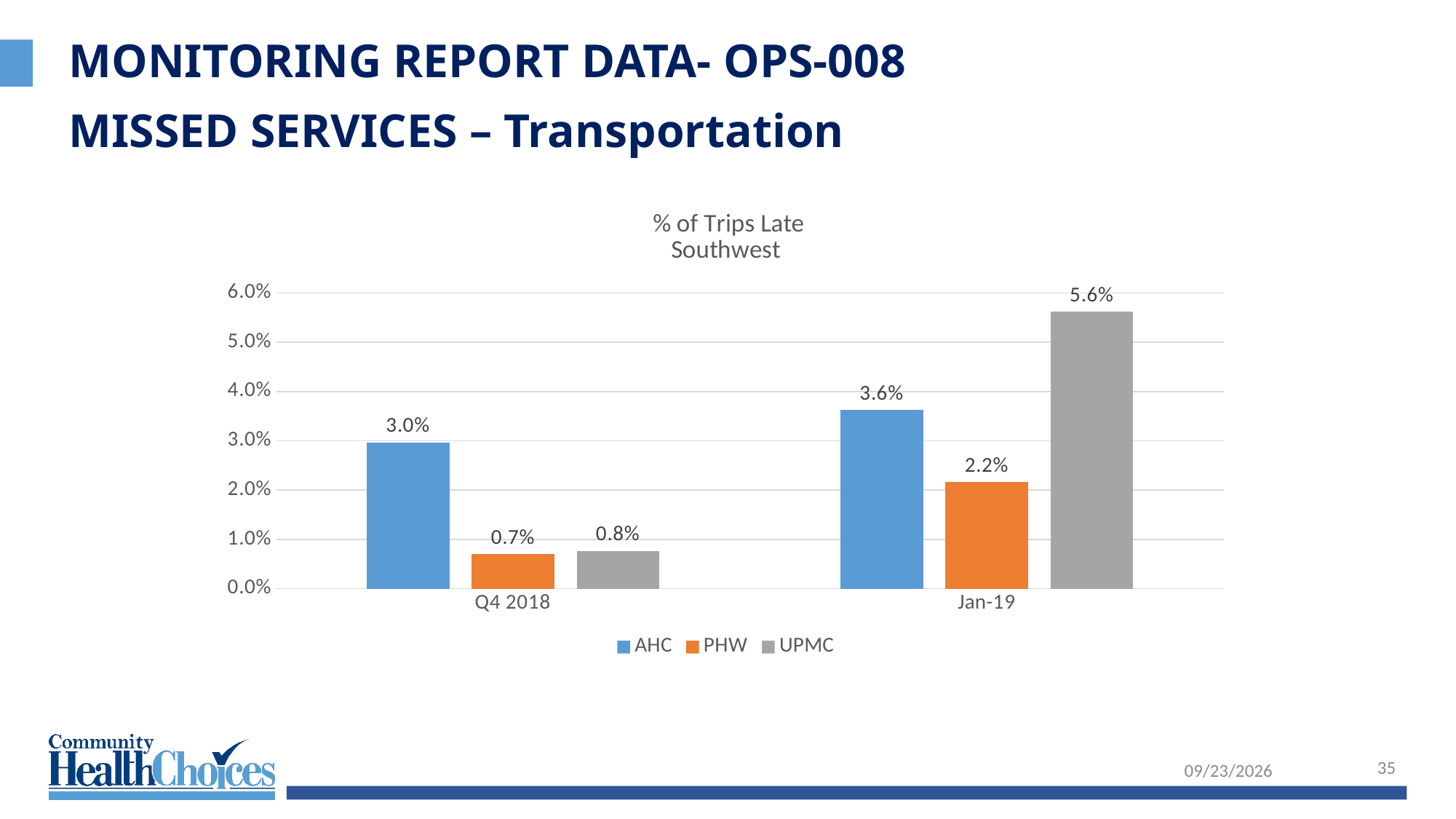
Does the PHW value rise or fall from Q4 2018 to Jan-19? rise What is the value for PHW in Q4 2018? 0.7% What kind of chart is shown? bar chart Which series has the highest value in Jan-19? UPMC What is the value for UPMC in Jan-19? 5.6% What is the value for AHC in Q4 2018? 3.0% How many series does the legend list? 3 How many periods are shown on the x axis? 2 Is the value for UPMC in Jan-19 greater or less than 5.0%? greater Which is larger, the AHC value in Jan-19 or the PHW value in Jan-19? AHC value in Jan-19 Which series has the lowest value in Q4 2018? PHW What is the difference between the UPMC values for Jan-19 and Q4 2018? 4.8%